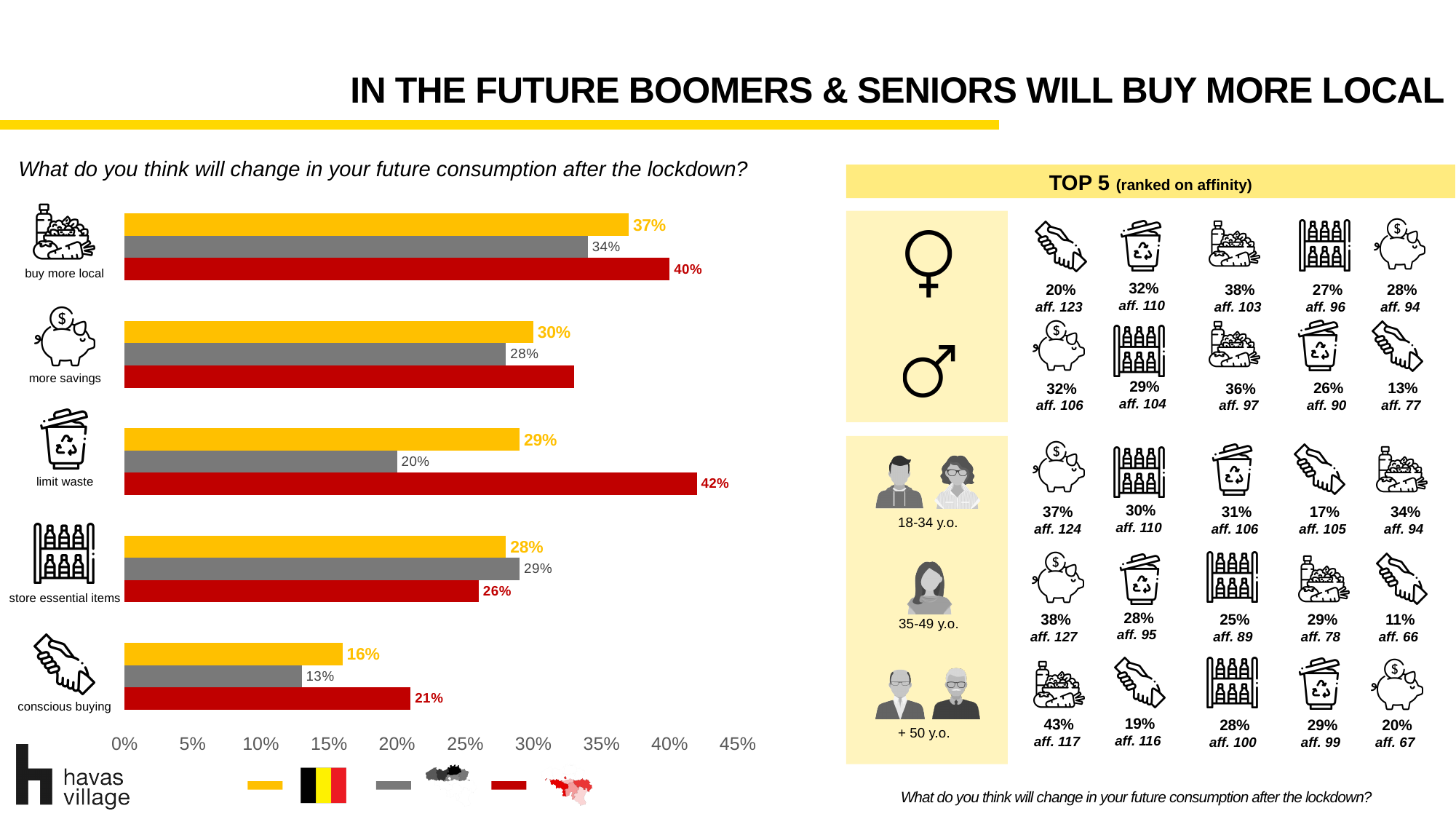
How many categories are shown in the bar chart? 5 In the bar chart, which is larger for 'store essential items': the grey bar or the red bar? the grey bar In the bar chart, what is the difference between the red and grey bars for 'limit waste'? 22% In the bar chart, what is the value of the grey bar for 'conscious buying'? 13% In the bar chart, is the value of the red bar for 'more savings' greater or less than 30%? greater In the bar chart, what is the difference between the yellow and grey bars for 'buy more local'? 3% In the bar chart, which category has the lowest value for the yellow series? conscious buying In the bar chart, which category has the highest value for the red series? limit waste In the bar chart, what is the value of the yellow bar for 'buy more local'? 37% In the bar chart, what is the value of the red bar for 'limit waste'? 42% What type of chart is shown on the left of the slide? bar chart What is the maximum value shown on the x axis of the bar chart? 45%